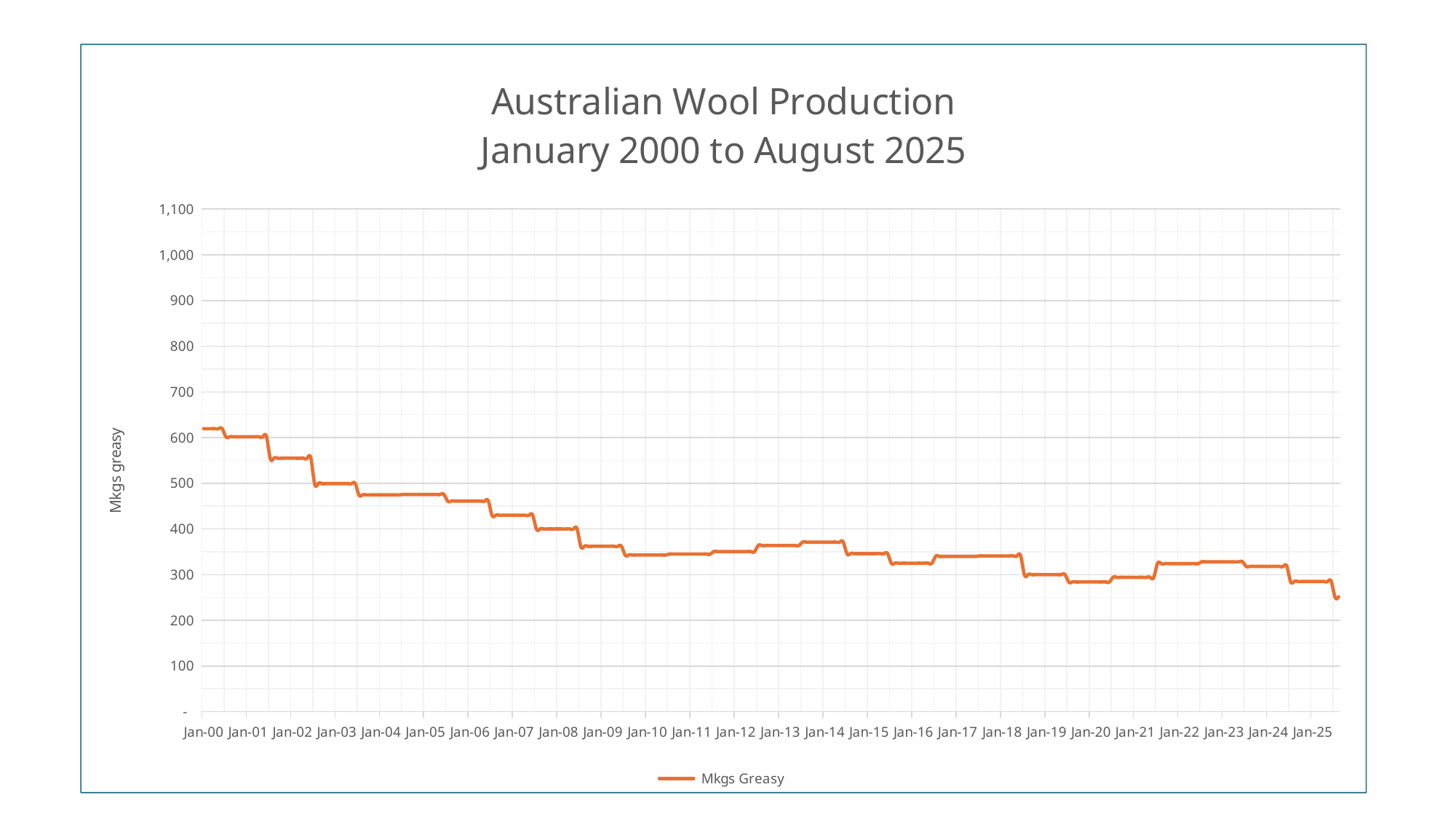
Is the value at Jan-25 greater or less than 300? less What is the label on the vertical axis? Mkgs greasy Is the value at Jan-10 greater or less than 400? less Which is larger, the value at Jan-02 or the value at Jan-12? Jan-02 Is the value at Jan-05 greater or less than 500? less What is the title of the chart? Australian Wool Production January 2000 to August 2025 How many series does the legend list? 1 Do the values generally rise or fall from Jan-00 to Jan-25? fall What kind of chart is shown on the slide? line chart